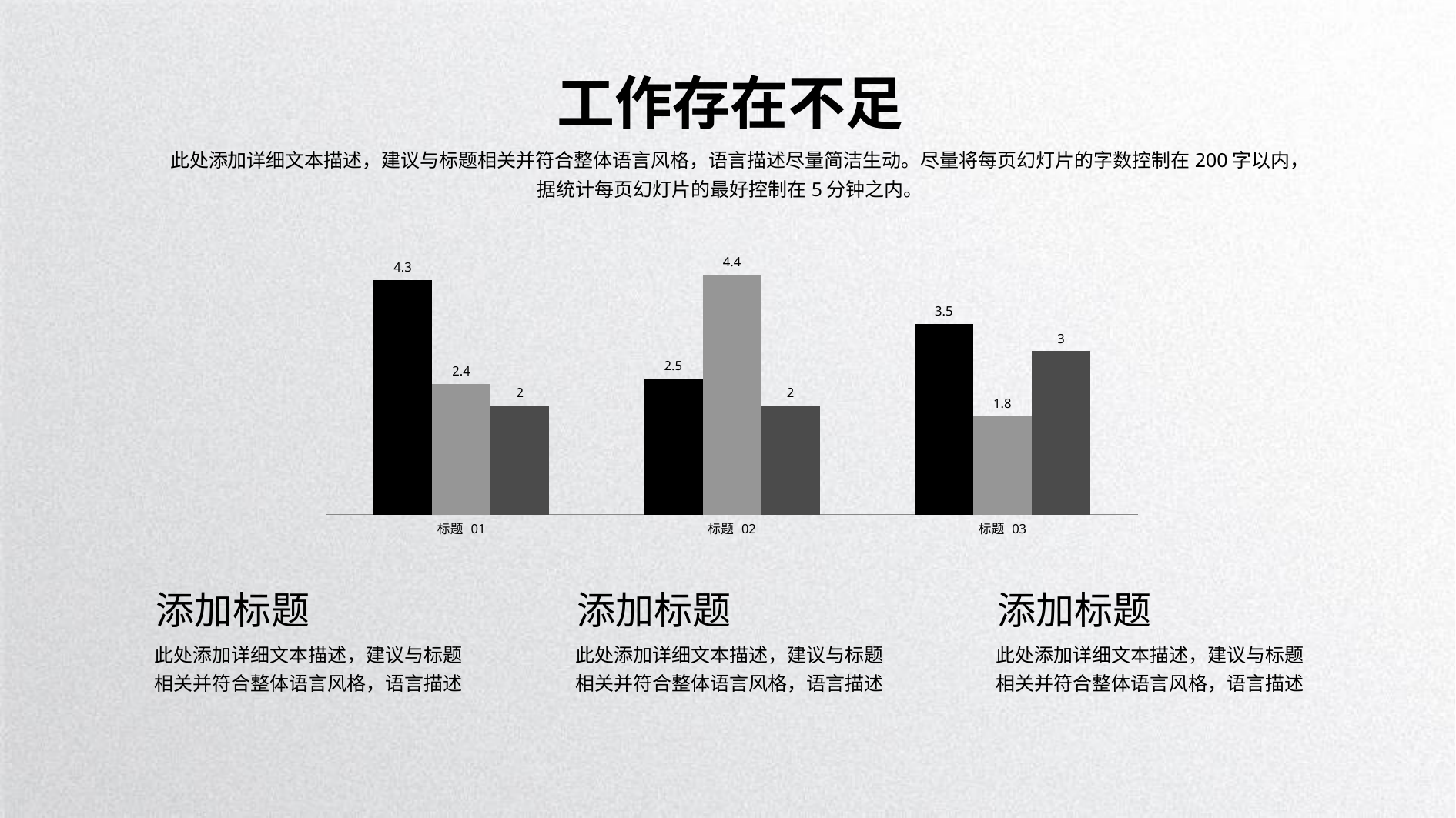
What is the value of the light gray bar for 标题 02? 4.4 What is the value of the black bar for 标题 01? 4.3 What type of chart is shown on the slide? bar chart Which category has the highest black bar? 标题 01 What is the difference between the black bar and the light gray bar for 标题 01? 1.9 How many bars are plotted for each category? 3 Which category has the lowest light gray bar? 标题 03 How many categories are shown on the x axis of the chart? 3 What is the value of the light gray bar for 标题 03? 1.8 What is the difference between the dark gray bars for 标题 03 and 标题 02? 1 Which is larger for 标题 02: the black bar or the light gray bar? the light gray bar What is the value of the dark gray bar for 标题 03? 3